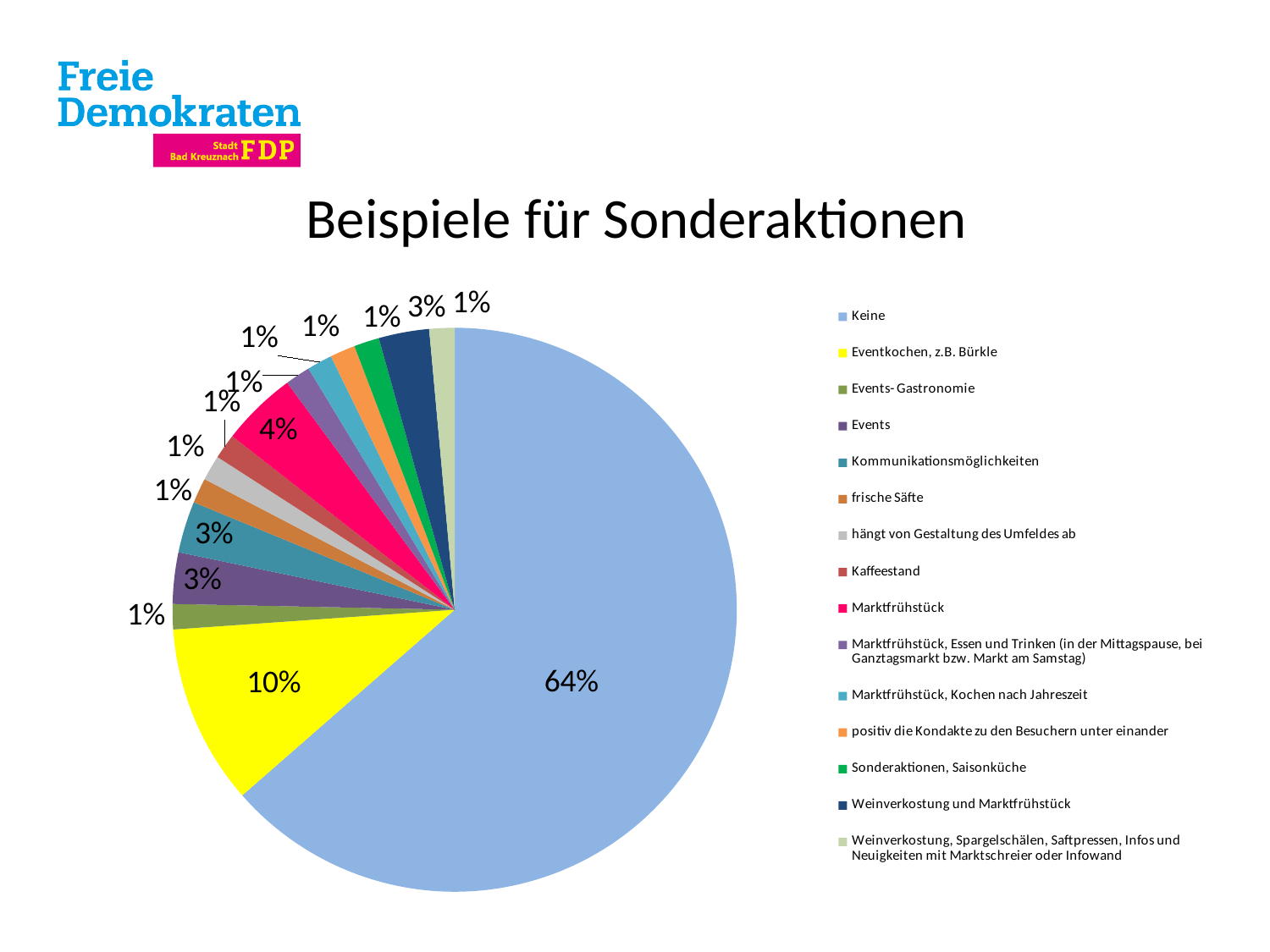
What is the title of the slide? Beispiele für Sonderaktionen What is the value shown for "Marktfrühstück"? 4% What is the value shown for "Eventkochen, z.B. Bürkle"? 10% Which is larger, the slice for "Marktfrühstück" or the slice for "Events"? Marktfrühstück Which is larger, the slice for "Eventkochen, z.B. Bürkle" or the slice for "Marktfrühstück"? Eventkochen, z.B. Bürkle What is the difference in percentage points between "Keine" and "Eventkochen, z.B. Bürkle"? 54 percentage points Which category has the largest slice of the pie? Keine What share of the pie does "Keine" represent? 64% What is the value shown for "Weinverkostung und Marktfrühstück"? 3% What kind of chart is shown on the slide? Pie chart How many categories does the legend list? 15 What is the value shown for "Kommunikationsmöglichkeiten"? 3%